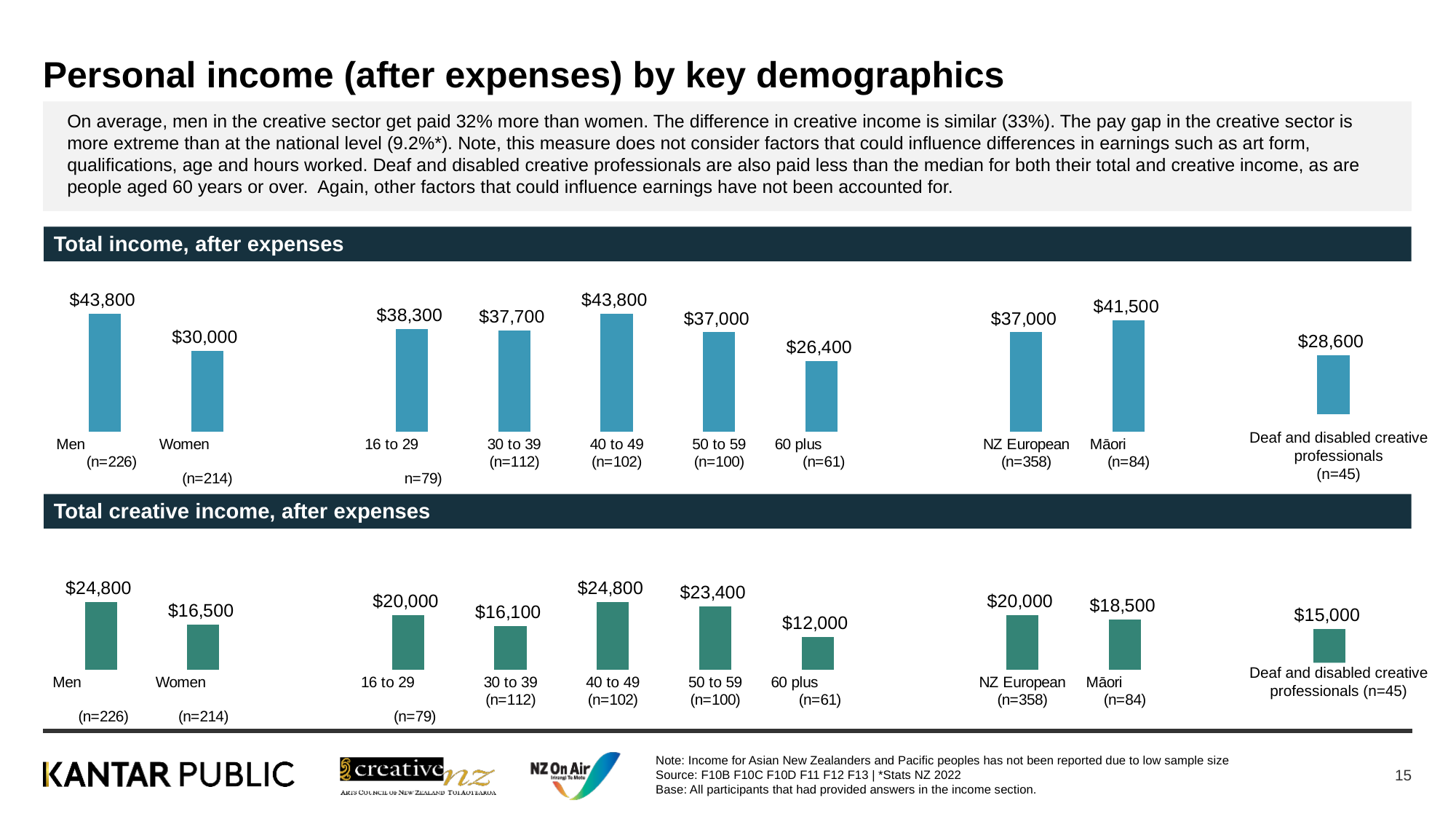
In the 'Total creative income, after expenses' chart, which is larger: the value for 50 to 59 or the value for 30 to 39? 50 to 59 In the 'Total creative income, after expenses' chart, what is the value for Deaf and disabled creative professionals? $15,000 In the 'Total income, after expenses' chart, what is the difference between the values for Men and Women? $13,800 How many bars are plotted in the 'Total creative income, after expenses' chart? 10 In the 'Total creative income, after expenses' chart, what is the value for Women? $16,500 In the 'Total creative income, after expenses' chart, what is the difference between the values for NZ European and Māori? $1,500 In the 'Total creative income, after expenses' chart, which category has the lowest value? 60 plus In the 'Total income, after expenses' chart, which is larger: the value for Deaf and disabled creative professionals or the value for Women? Women What kind of chart is the 'Total income, after expenses' chart? Bar chart In the 'Total income, after expenses' chart, which category has the lowest value? 60 plus In the 'Total income, after expenses' chart, what is the value for Men? $43,800 In the 'Total income, after expenses' chart, what is the value for Māori? $41,500